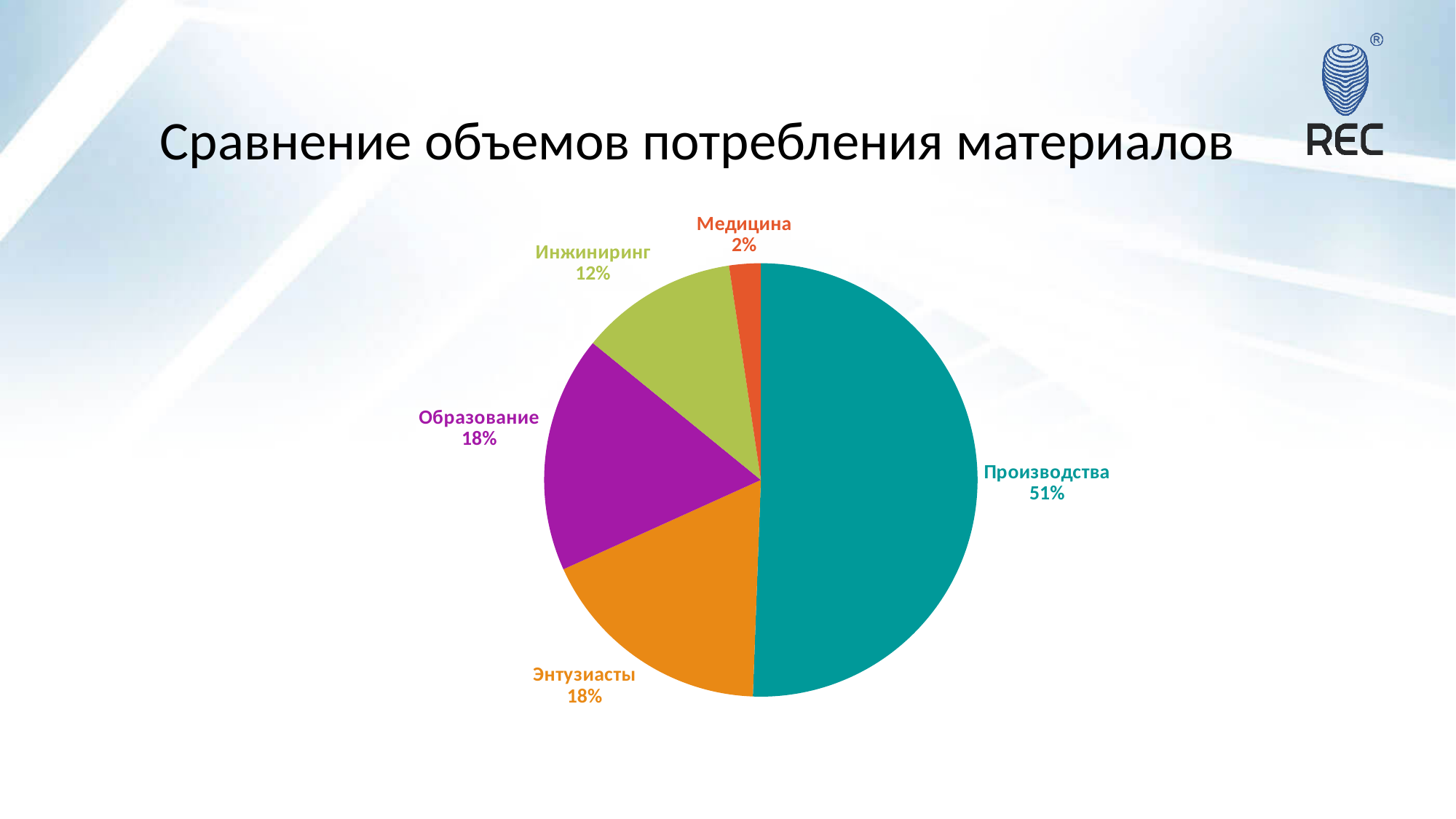
What is the difference in percentage points between Образование and Инжиниринг? 6 Which is larger, the share for Инжиниринг or the share for Медицина? Инжиниринг Which category has the smallest slice of the pie? Медицина What share of the pie does Образование have? 18% What share of the pie does Производства have? 51% What share of the pie does Медицина have? 2% What is the title of the slide containing the chart? Сравнение объемов потребления материалов What is the difference in percentage points between Производства and Энтузиасты? 33 How many categories are shown in the pie chart? 5 What share of the pie does Инжиниринг have? 12% What kind of chart is shown on the slide? Pie chart Which category has the largest slice of the pie? Производства